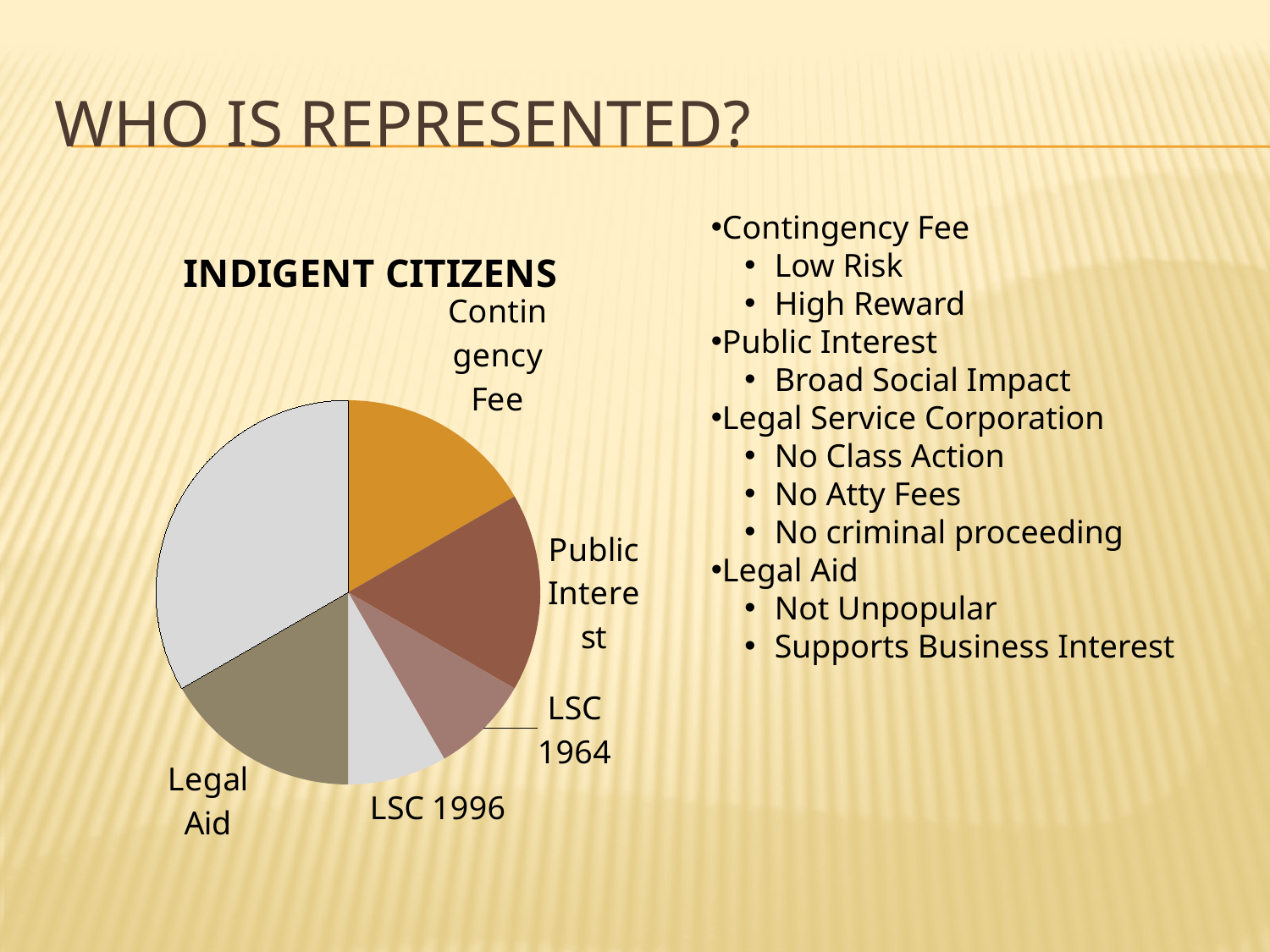
Which slice is larger, Legal Aid or LSC 1964? Legal Aid What kind of chart is shown on the slide? pie chart What colour is the Contingency Fee slice of the pie chart? orange How many slices of the pie chart have a readable label? 5 Which slice is larger, Legal Aid or LSC 1996? Legal Aid Which slice is larger, Contingency Fee or LSC 1964? Contingency Fee How many slices does the pie chart have? 6 What is the title of the pie chart? INDIGENT CITIZENS